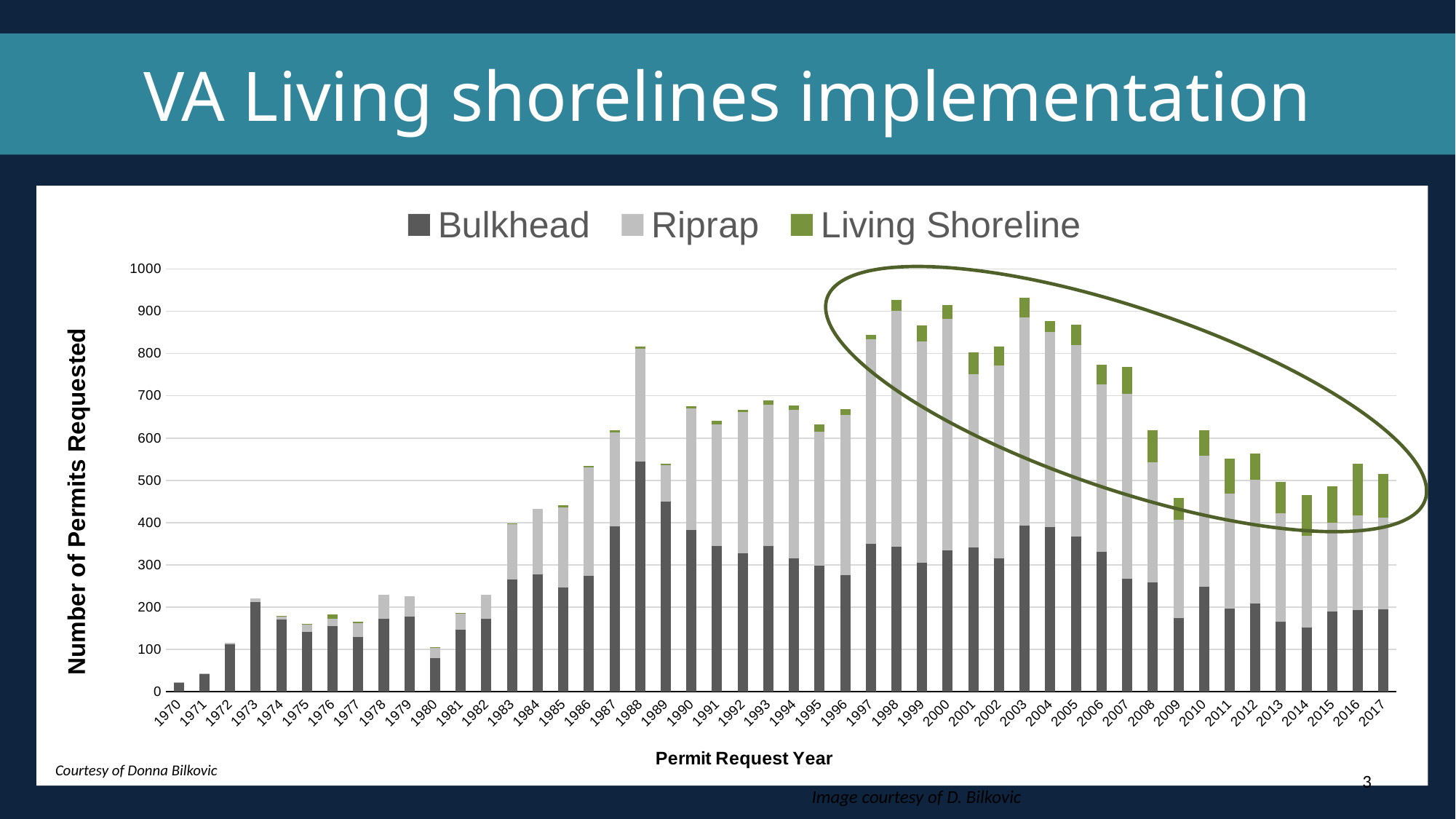
Which year has the lowest total number of permits requested? 1970 Is the total number of permits requested in 1988 greater or less than 800? greater How many series does the legend list? 3 Is the total number of permits requested in 1997 greater or less than 800? greater Which year has the larger total number of permits requested, 1988 or 1989? 1988 Do the total permits requested rise or fall from 2003 to 2009? fall Is the total number of permits requested in 2009 greater or less than 500? less Which series is shown in green in the legend? Living Shoreline What is the title of the x axis? Permit Request Year How many years are shown along the x axis? 48 What kind of chart is shown on the slide? Stacked bar chart